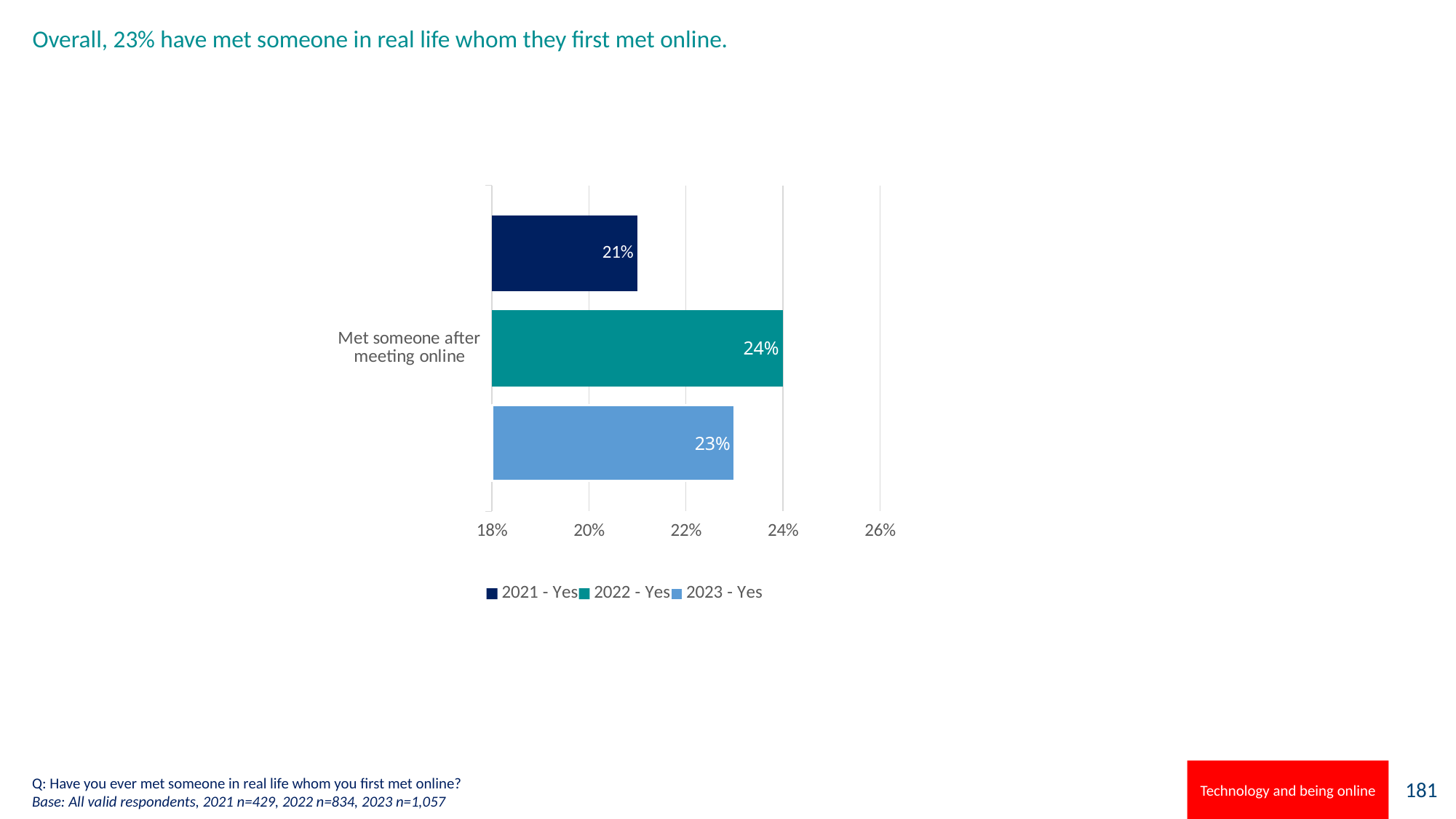
Which is larger, the 2022 - Yes value or the 2023 - Yes value? 2022 - Yes Which year has the lowest value for 'Met someone after meeting online'? 2021 - Yes What is the category label shown on the chart's axis? Met someone after meeting online What is the difference between the 2023 - Yes and 2021 - Yes values? 2% What is the difference between the 2022 - Yes and 2021 - Yes values? 3% How many series does the legend list? 3 Which year has the highest value for 'Met someone after meeting online'? 2022 - Yes What kind of chart is shown on the slide? Bar chart Is the value for 2021 - Yes greater or less than 22%? less What is the value for 2022 - Yes for 'Met someone after meeting online'? 24% What is the value for 2023 - Yes for 'Met someone after meeting online'? 23% What is the value for 2021 - Yes for 'Met someone after meeting online'? 21%